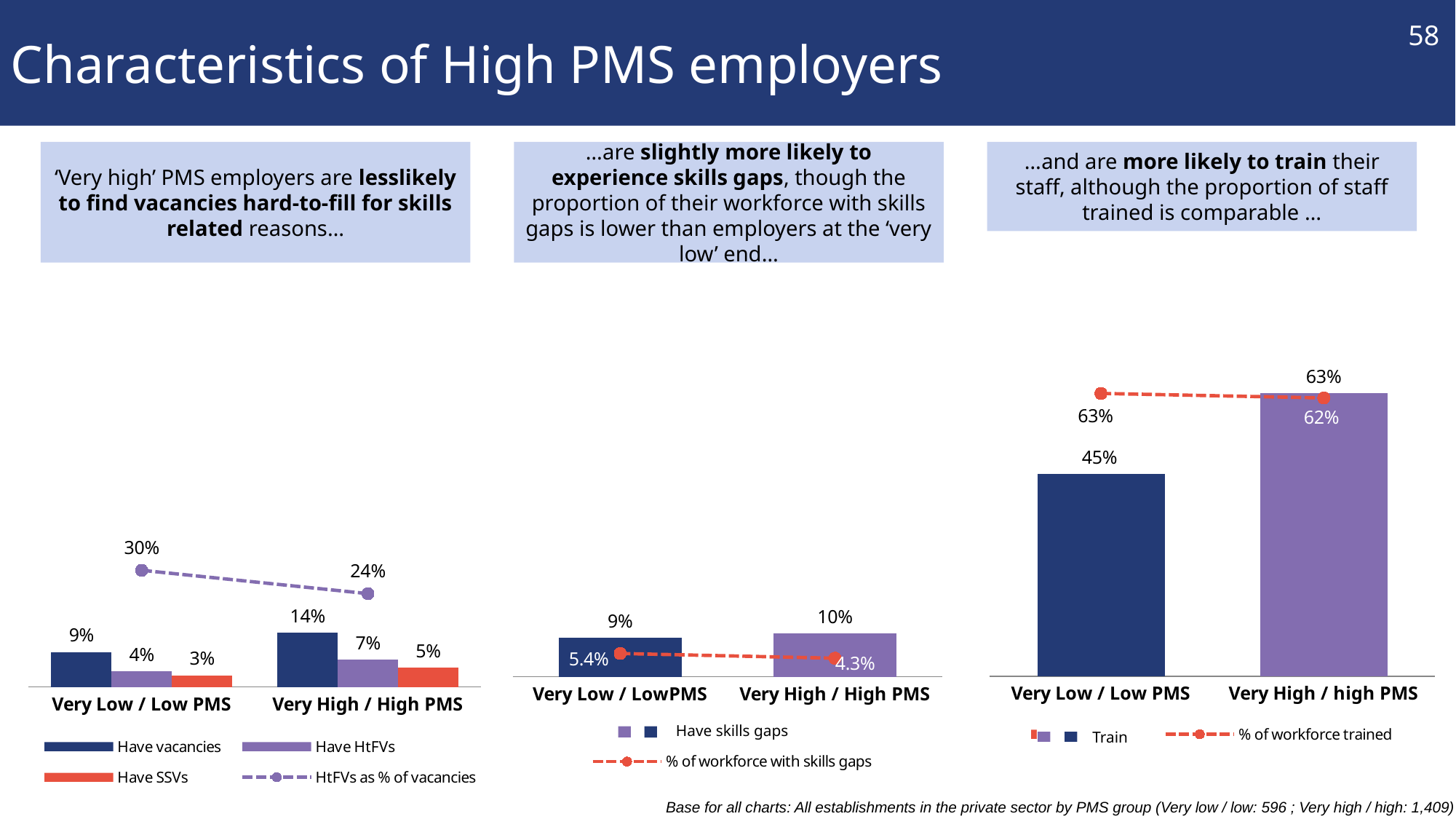
In the left chart, does HtFVs as % of vacancies rise or fall from Very Low / Low PMS to Very High / High PMS? fall What type of chart is the right chart? Bar chart with a line In the middle chart, which group has the higher % of workforce with skills gaps? Very Low / Low PMS In the left chart, what percentage of Very Low / Low PMS employers have vacancies? 9% In the left chart, how many series does the legend list? 4 In the middle chart, what percentage of Very High / High PMS employers have skills gaps? 10% In the middle chart, what is the % of workforce with skills gaps for Very Low / Low PMS employers? 5.4% In the right chart, what percentage of Very Low / Low PMS employers train their staff? 45% In the left chart, what is the value of HtFVs as % of vacancies for Very High / High PMS employers? 24% In the right chart, what is the difference in the Train value between Very High / high PMS and Very Low / Low PMS employers? 18% In the right chart, what is the % of workforce trained for Very High / high PMS employers? 62% In the left chart, what is the difference between the Have vacancies values for Very High / High PMS and Very Low / Low PMS? 5%